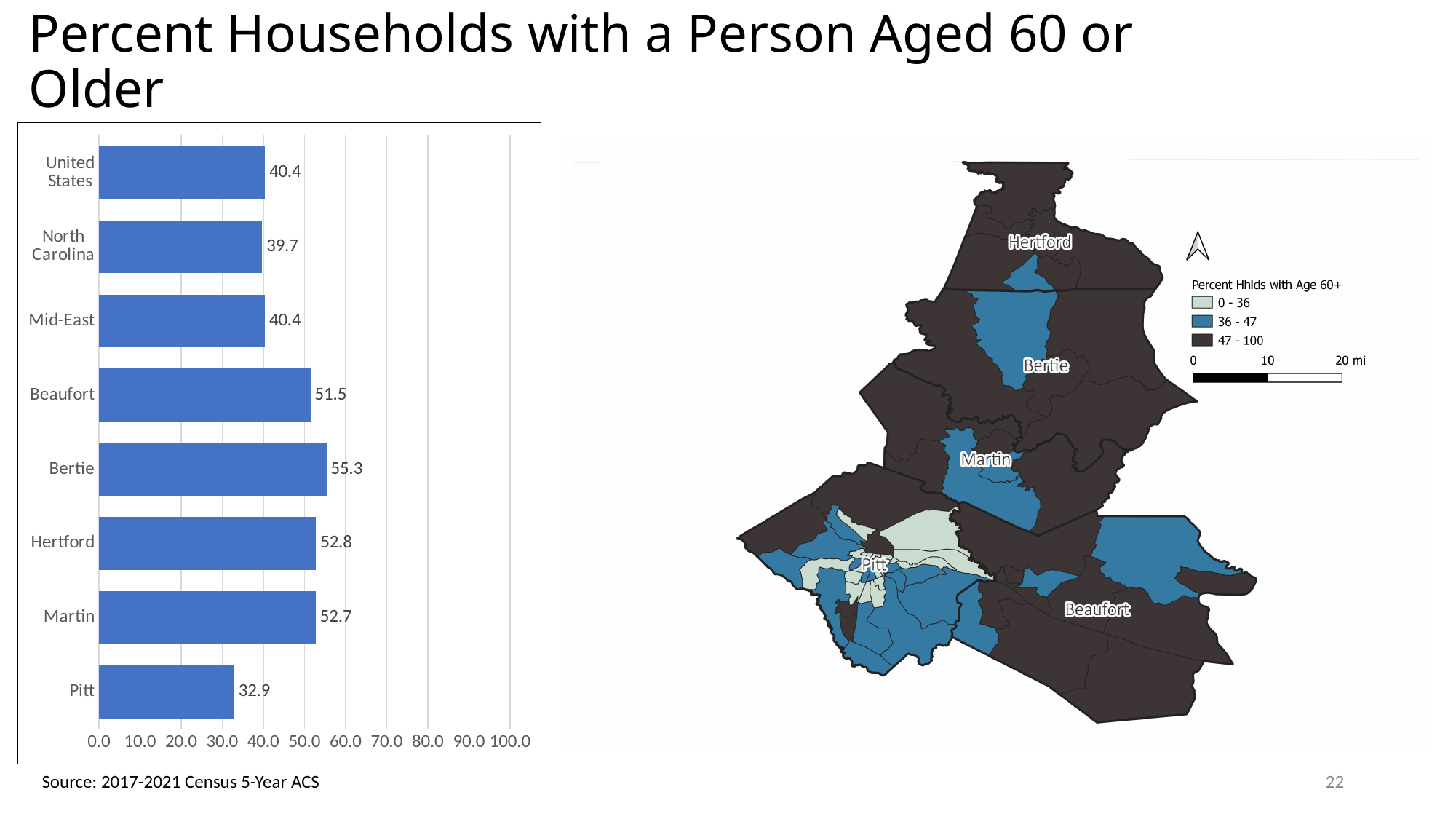
What is the value for North Carolina in the bar chart? 39.7 What is the value for Beaufort in the bar chart? 51.5 What is the value for Pitt in the bar chart? 32.9 How many categories are shown in the bar chart? 8 In the bar chart, which is larger, the value for Hertford or the value for Beaufort? Hertford What is the difference between the values for Bertie and Pitt in the bar chart? 22.4 Is the value for Martin in the bar chart greater or less than 50.0? greater Which category has the highest value in the bar chart? Bertie What is the difference between the values for Beaufort and North Carolina in the bar chart? 11.8 What is the value for Bertie in the bar chart? 55.3 Which category has the lowest value in the bar chart? Pitt What kind of chart is shown on the left of the slide? Bar chart